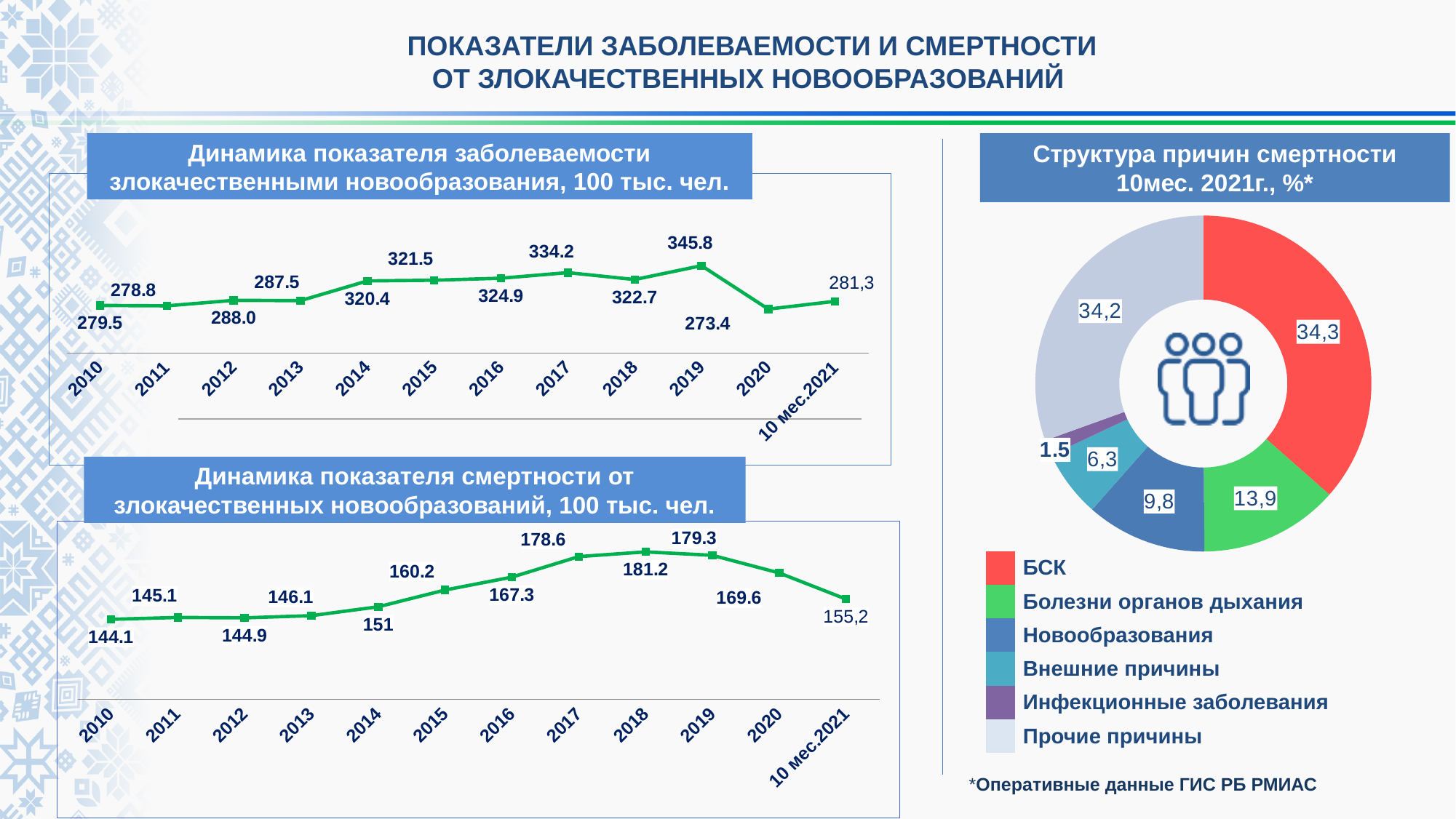
In the top-left chart 'Динамика показателя заболеваемости злокачественными новообразования', how many data points are plotted? 12 In the bottom-left chart 'Динамика показателя смертности от злокачественных новообразований', which year has the highest value? 2018 In the bottom-left chart 'Динамика показателя смертности от злокачественных новообразований', which is larger: the value for 2017 or the value for 2019? 2019 In the right chart 'Структура причин смертности 10мес. 2021г., %', which category has the smallest share? Инфекционные заболевания In the bottom-left chart 'Динамика показателя смертности от злокачественных новообразований', what is the difference between the 2018 value and the 2010 value? 37.1 In the bottom-left chart 'Динамика показателя смертности от злокачественных новообразований', what is the value for 2014? 151 In the top-left chart 'Динамика показателя заболеваемости злокачественными новообразования', which year has the lowest value? 2020 In the top-left chart 'Динамика показателя заболеваемости злокачественными новообразования', what is the value for 2019? 345.8 How many categories does the legend of the right chart 'Структура причин смертности 10мес. 2021г., %' list? 6 In the top-left chart 'Динамика показателя заболеваемости злокачественными новообразования', what is the difference between the 2019 value and the 2020 value? 72.4 What kind of chart is the bottom-left chart 'Динамика показателя смертности от злокачественных новообразований'? Line chart In the right chart 'Структура причин смертности 10мес. 2021г., %', what is the share for Новообразования? 9,8